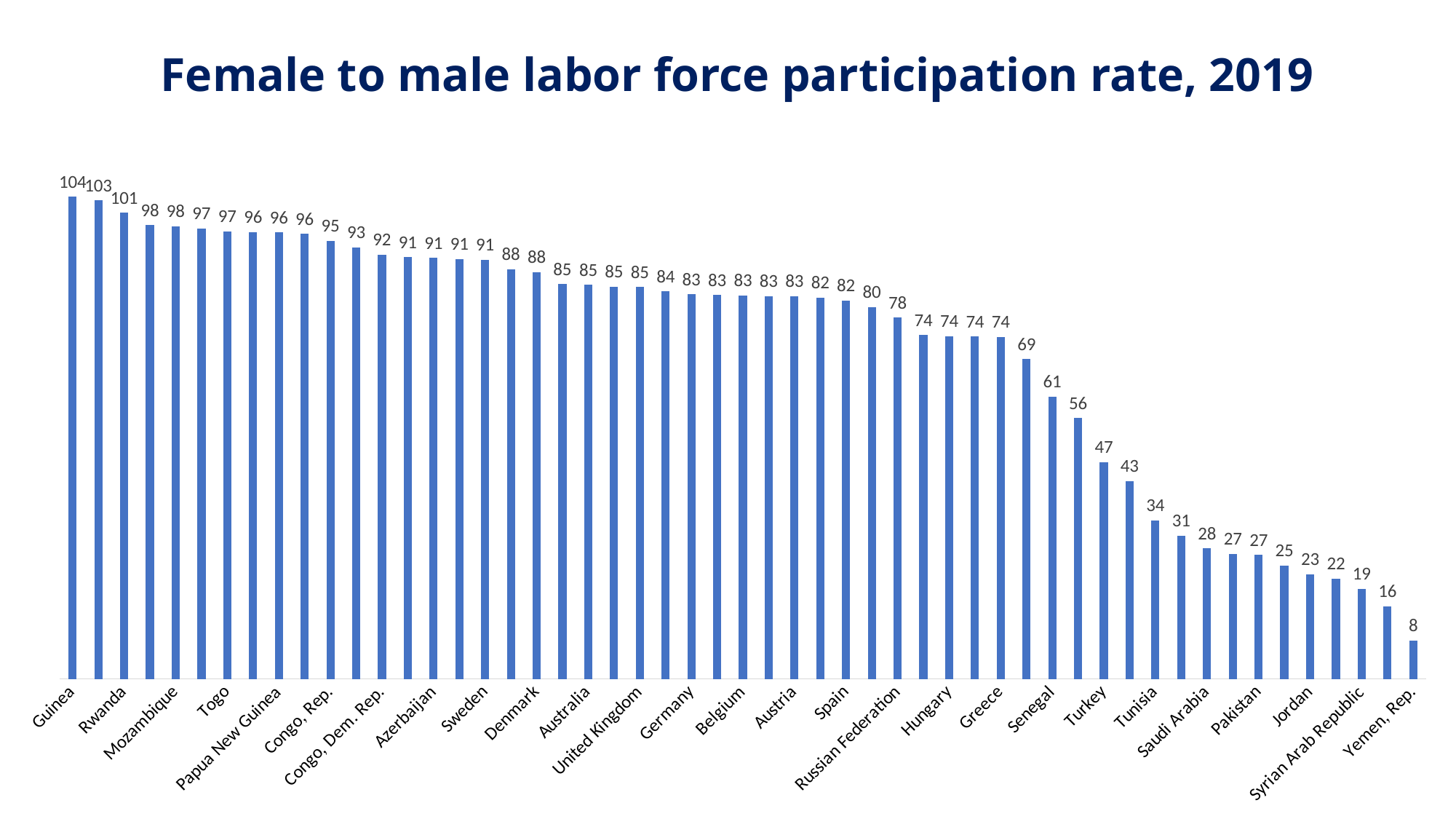
What is the title of the chart? Female to male labor force participation rate, 2019 What is the difference between the values for Guinea and Yemen, Rep.? 96 What is the value for Senegal? 61 What is the value for Yemen, Rep.? 8 Which country has the lowest female to male labor force participation rate? Yemen, Rep. Which country has the highest female to male labor force participation rate? Guinea What is the value for Guinea? 104 Which has a higher value, Senegal or Turkey? Senegal Do the values rise or fall moving from left to right along the x axis? fall What is the value for Turkey? 47 What type of chart is shown on the slide? bar chart What is the value for Tunisia? 34